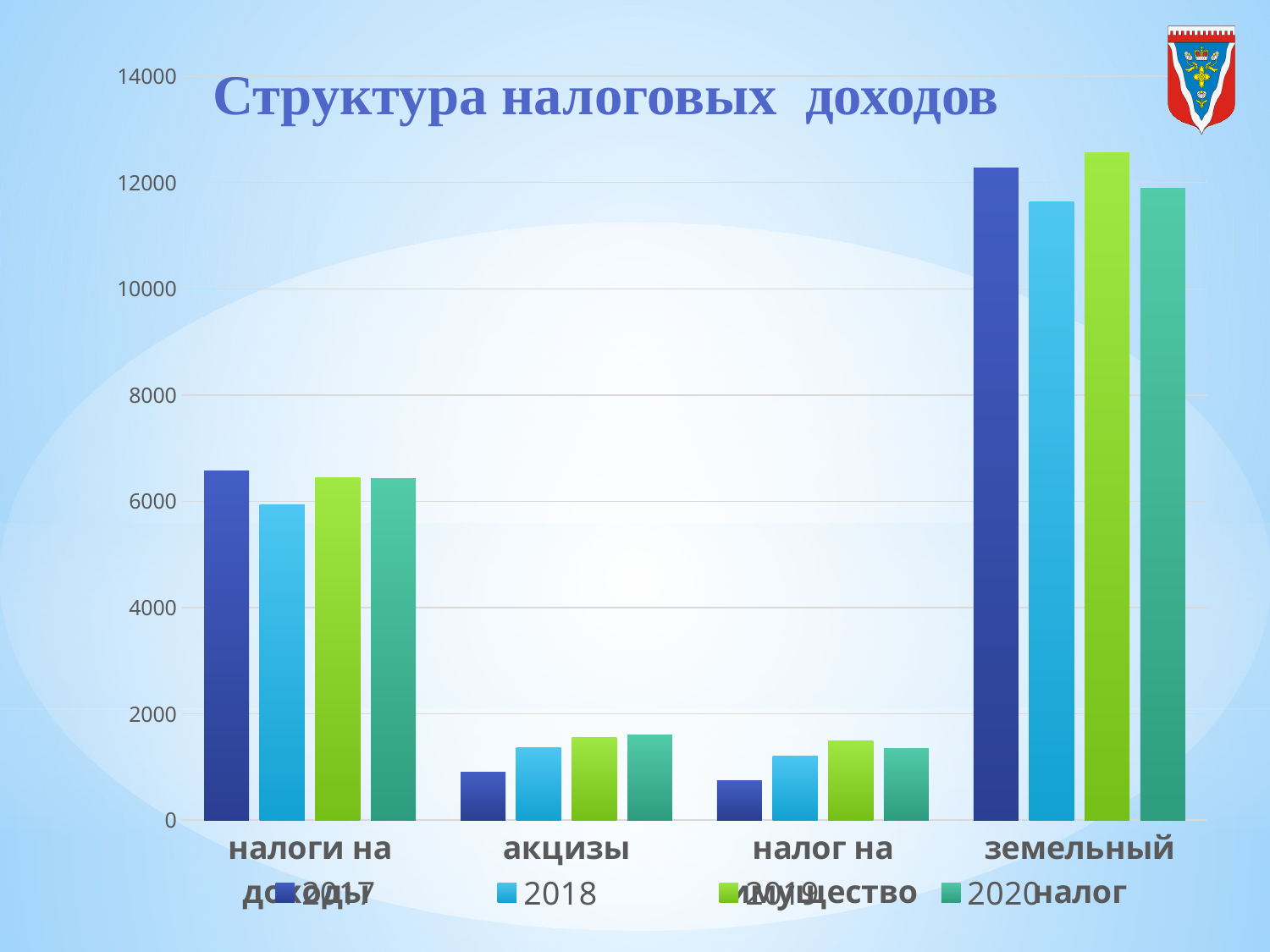
Is the value for акцизы in 2017 greater or less than 2000? less Which is larger for налоги на доходы: the 2017 value or the 2018 value? 2017 Is the value for земельный налог in 2018 greater or less than 12000? less Which is larger for земельный налог: the 2019 value or the 2018 value? 2019 What is the title of the chart? Структура налоговых доходов Which category has the highest values in the chart? земельный налог Is the value for налоги на доходы in 2017 greater or less than 6000? greater How many categories are shown on the x axis? 4 What kind of chart is shown on the slide? bar chart Which year has the tallest bar for земельный налог? 2019 How many series does the legend list? 4